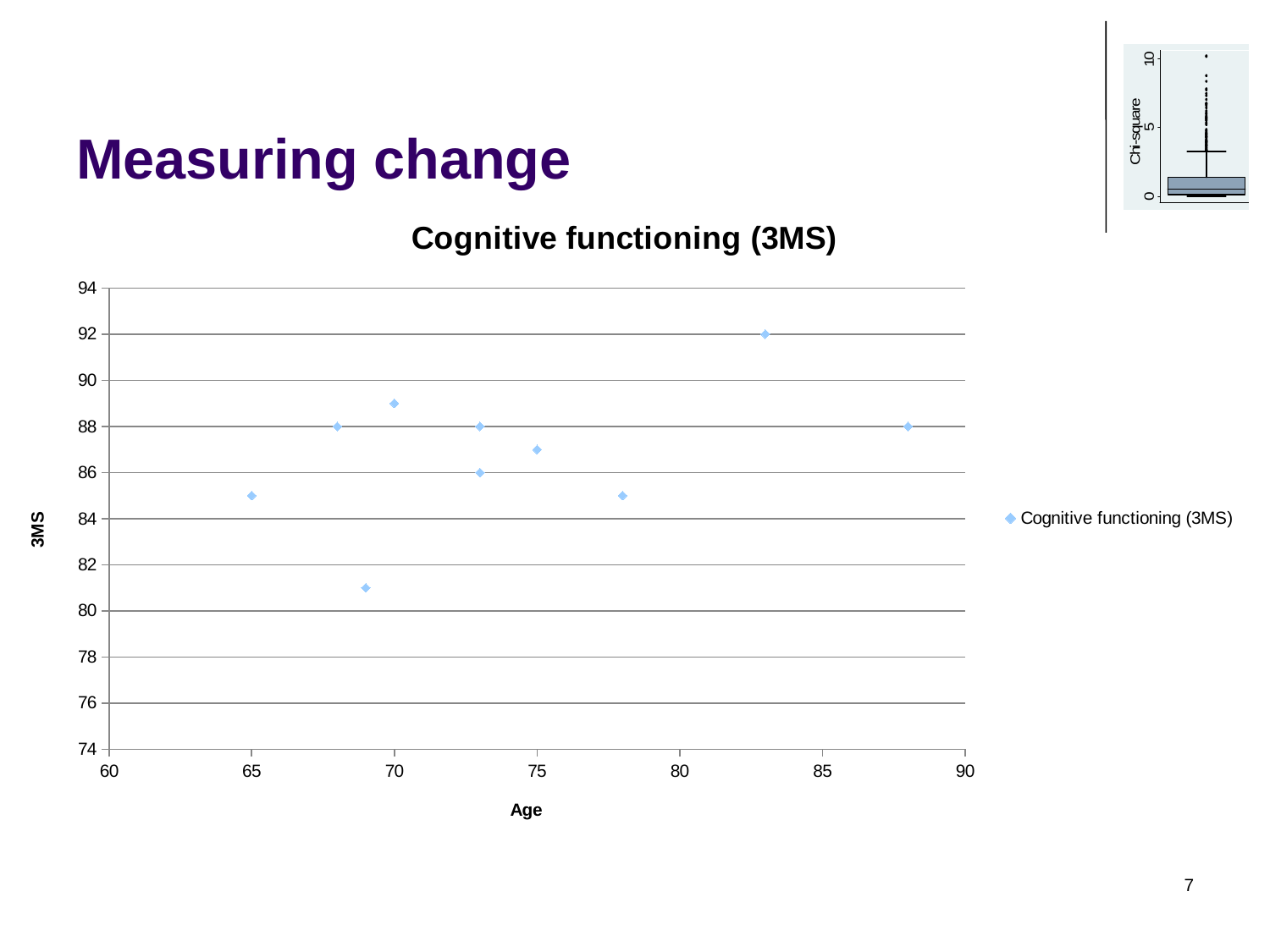
In the Cognitive functioning (3MS) chart, is the 3MS value for the point at age 69 greater or less than 82? less How many series does the legend of the Cognitive functioning (3MS) chart list? 1 How many data points are plotted in the Cognitive functioning (3MS) chart? 10 What kind of chart is shown under the title "Cognitive functioning (3MS)"? scatter chart In the Cognitive functioning (3MS) chart, which has the larger 3MS value: the point at age 83 or the point at age 88? age 83 In the Cognitive functioning (3MS) chart, what is the 3MS value for the point at age 83? 92 In the Cognitive functioning (3MS) chart, what is the difference in 3MS between the point at age 83 and the point at age 88? 4 What is the label of the x axis in the Cognitive functioning (3MS) chart? Age In the Cognitive functioning (3MS) chart, what is the 3MS value for the point at age 88? 88 In the Cognitive functioning (3MS) chart, is the 3MS value for the point at age 70 greater or less than 88? greater